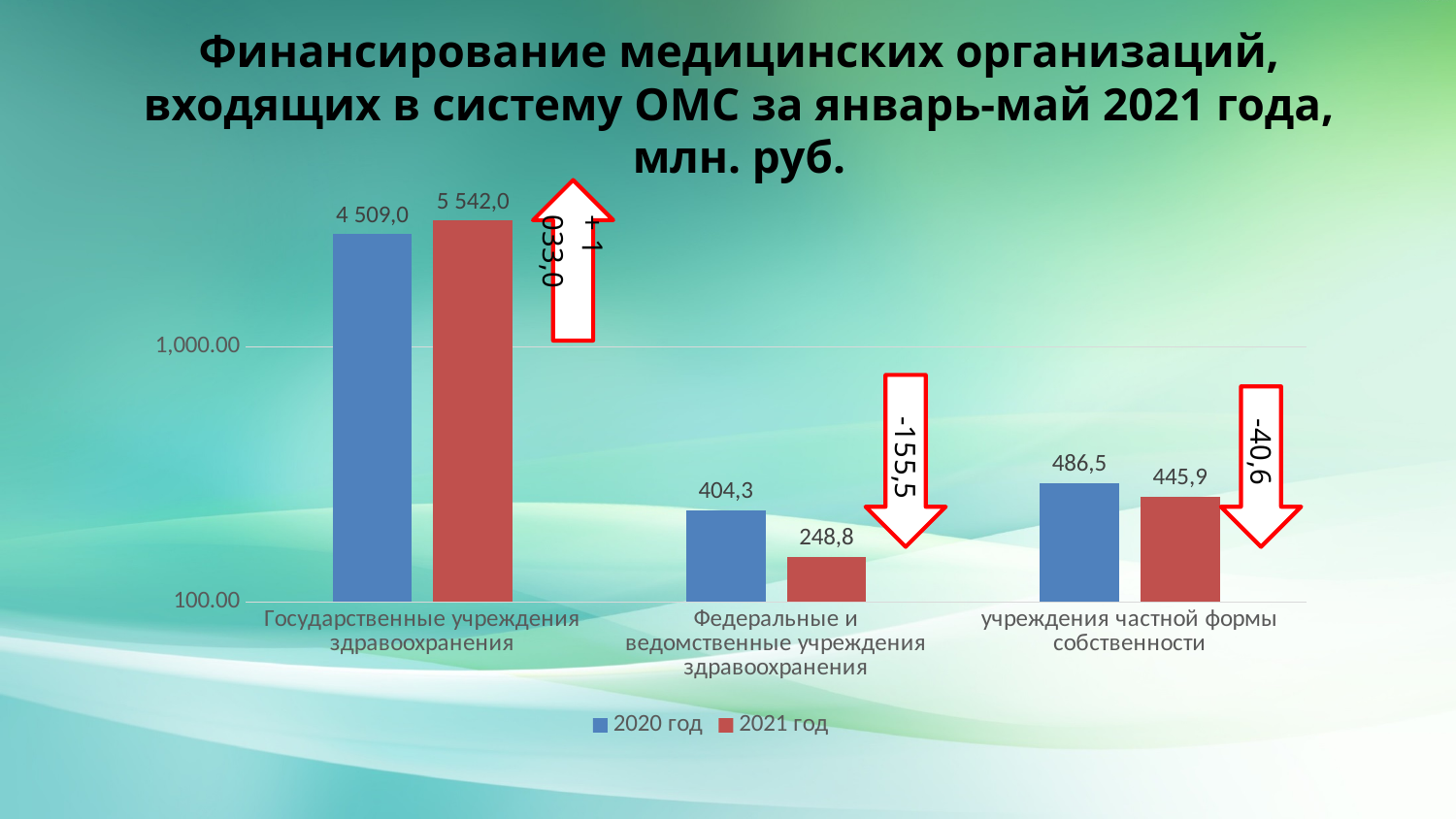
What kind of chart is shown on the slide? Bar chart Which category has the lowest value in the 2020 год series? Федеральные и ведомственные учреждения здравоохранения What is the value for Государственные учреждения здравоохранения in the 2020 год series? 4 509,0 How many categories are shown on the x axis? 3 Which is larger for учреждения частной формы собственности: the 2020 год value or the 2021 год value? 2020 год What is the value for Федеральные и ведомственные учреждения здравоохранения in the 2021 год series? 248,8 What change does the arrow above the Государственные учреждения здравоохранения bars show? +1 033,0 Which category has the highest value in the 2021 год series? Государственные учреждения здравоохранения What is the value for учреждения частной формы собственности in the 2020 год series? 486,5 How many series does the legend list? 2 What is the value for Государственные учреждения здравоохранения in the 2021 год series? 5 542,0 What is the difference between the 2021 год and 2020 год values for Федеральные и ведомственные учреждения здравоохранения? 155,5